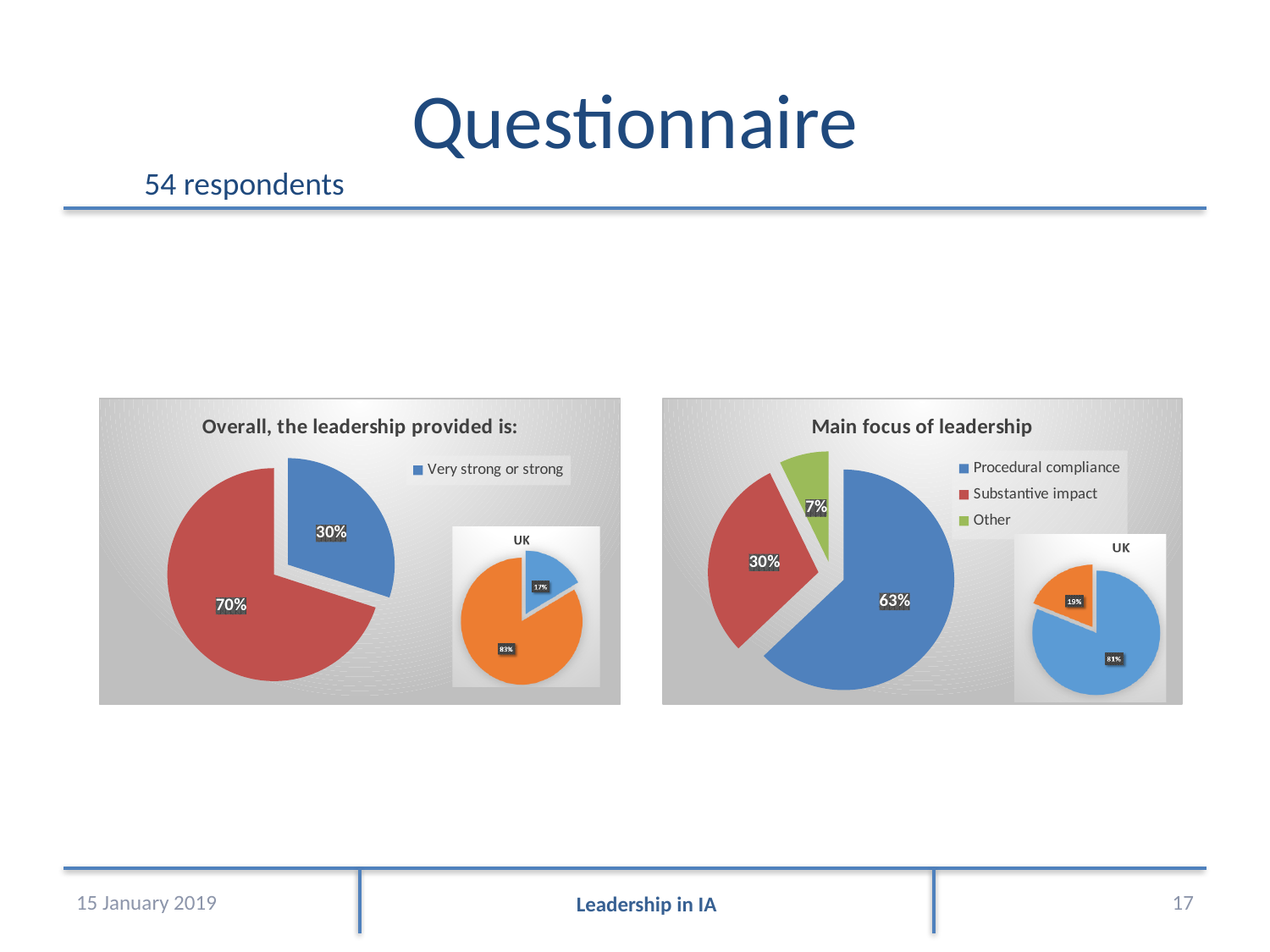
In the chart titled "Main focus of leadership", how many entries does the legend list? 3 In the small "UK" inset pie inside the chart titled "Overall, the leadership provided is:", what percentage is shown on the blue slice? 17% In the chart titled "Main focus of leadership", what percentage is shown for "Procedural compliance"? 63% In the chart titled "Main focus of leadership", which category has the smallest share? Other What type of chart is the chart titled "Main focus of leadership"? Pie chart In the chart titled "Overall, the leadership provided is:", what percentage is shown for "Very strong or strong"? 30% In the chart titled "Main focus of leadership", which category has the largest share? Procedural compliance In the chart titled "Main focus of leadership", what percentage is shown for "Substantive impact"? 30% In the small "UK" inset pie inside the chart titled "Main focus of leadership", what percentage is shown on the blue slice? 81% In the chart titled "Overall, the leadership provided is:", what percentage is shown on the red slice? 70% In the chart titled "Main focus of leadership", what percentage is shown for "Other"? 7% In the chart titled "Main focus of leadership", how many percentage points larger is "Procedural compliance" than "Substantive impact"? 33 percentage points